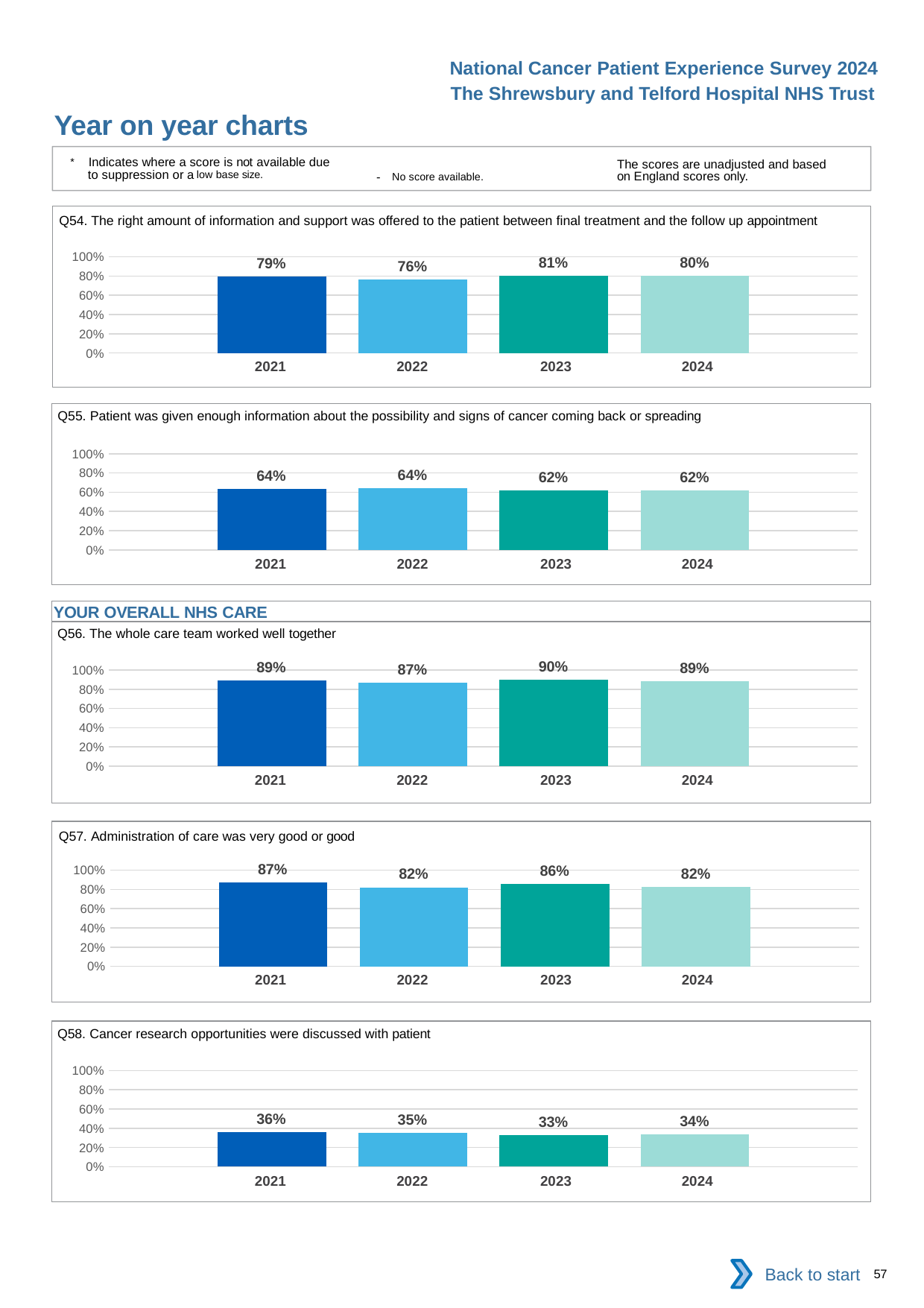
In the Q57 chart, what is the difference between the 2021 and 2022 values? 5% In the Q54 chart, which is larger, the value for 2021 or the value for 2022? 2021 What kind of chart is the Q56 chart? bar chart In the Q56 chart, which year has the highest value? 2023 In the Q55 chart, what is the value for 2024? 62% In the Q58 chart, which year has the lowest value? 2023 In the Q56 chart, what is the difference between the 2023 and 2022 values? 3% In the Q54 chart, what is the value for 2023? 81% In the Q55 chart, what is the value for 2021? 64% In the Q58 chart, is the value for 2021 greater or less than 40%? less How many years are shown in the Q57 chart? 4 What is the title of the chart at the bottom of the slide? Q58. Cancer research opportunities were discussed with patient